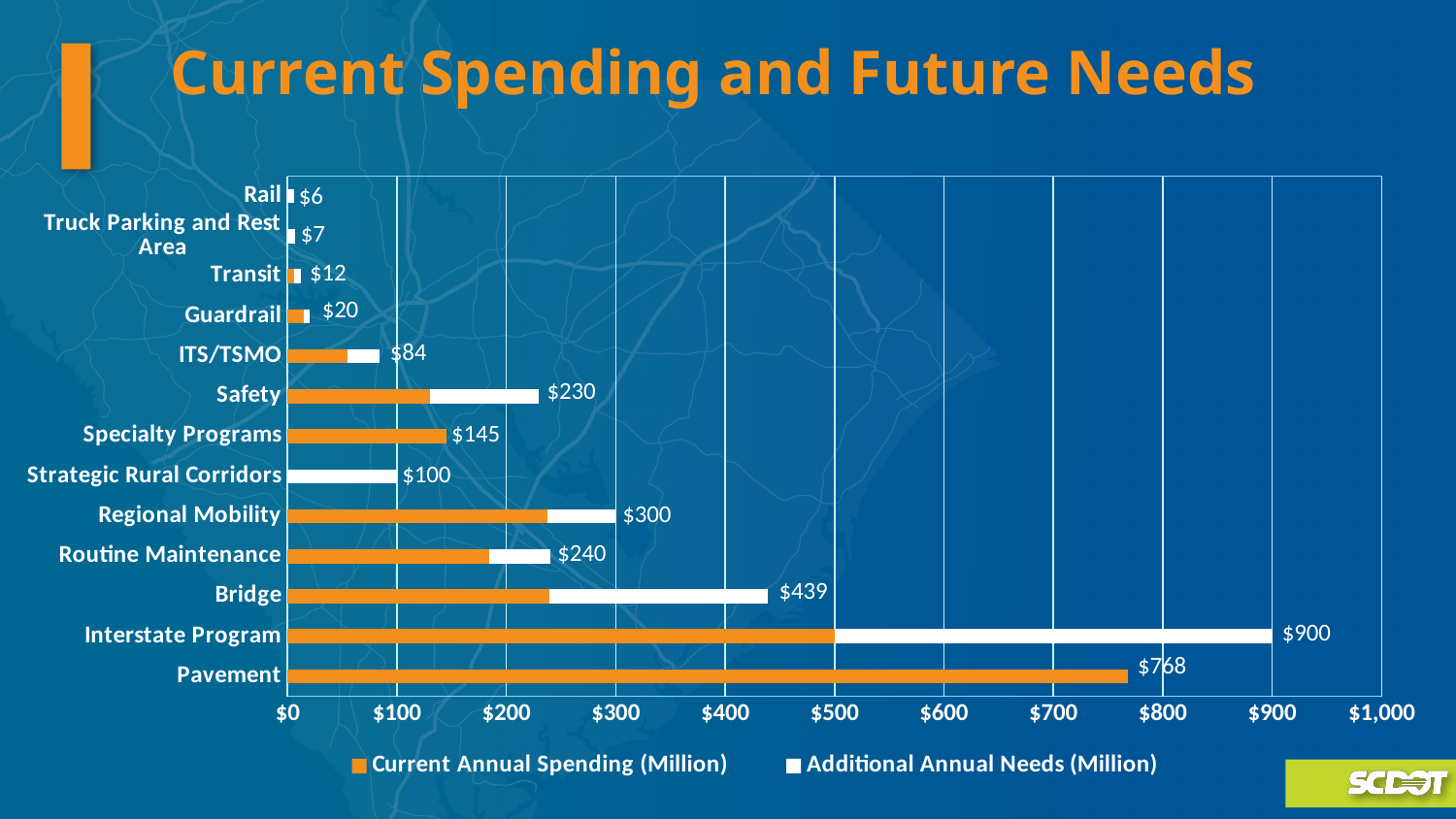
Which has a larger labeled total, Safety or Specialty Programs? Safety Which category has the lowest total value? Rail What is the difference between the labeled totals for Interstate Program and Pavement? $132 What is the total value labeled for the Bridge bar? $439 How many series does the legend list? 2 What is the total value labeled for the Interstate Program bar? $900 How many categories are shown on the chart? 13 Is the Current Annual Spending value for Pavement greater or less than $700? greater What is the total value labeled for Strategic Rural Corridors? $100 Is the Current Annual Spending value for Interstate Program greater or less than $400? greater What type of chart is shown on the slide? Stacked bar chart Which category has the highest total value? Interstate Program